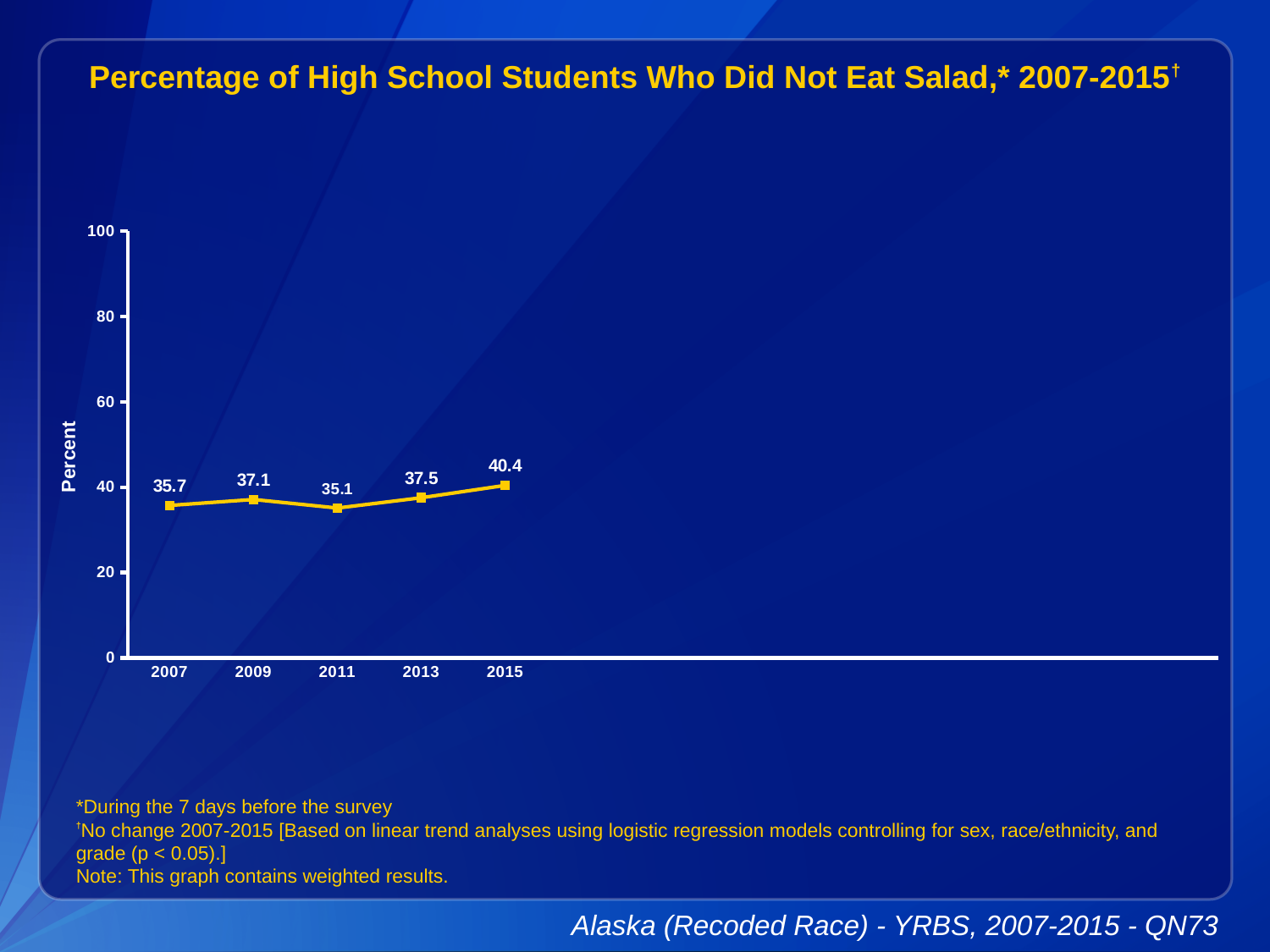
What is the difference between the 2013 value and the 2011 value? 2.4 Is the value for 2015 greater or less than 40? greater What kind of chart is shown on the slide? line chart What is the label on the y axis? Percent Which year has a larger value, 2009 or 2013? 2013 Which year has the lowest percentage of students who did not eat salad? 2011 Which year has the highest percentage of students who did not eat salad? 2015 How many years are plotted on the chart? 5 What is the value plotted for 2011? 35.1 What percentage of high school students did not eat salad in 2007? 35.7 What is the value plotted for 2015? 40.4 What is the difference between the 2015 value and the 2007 value? 4.7